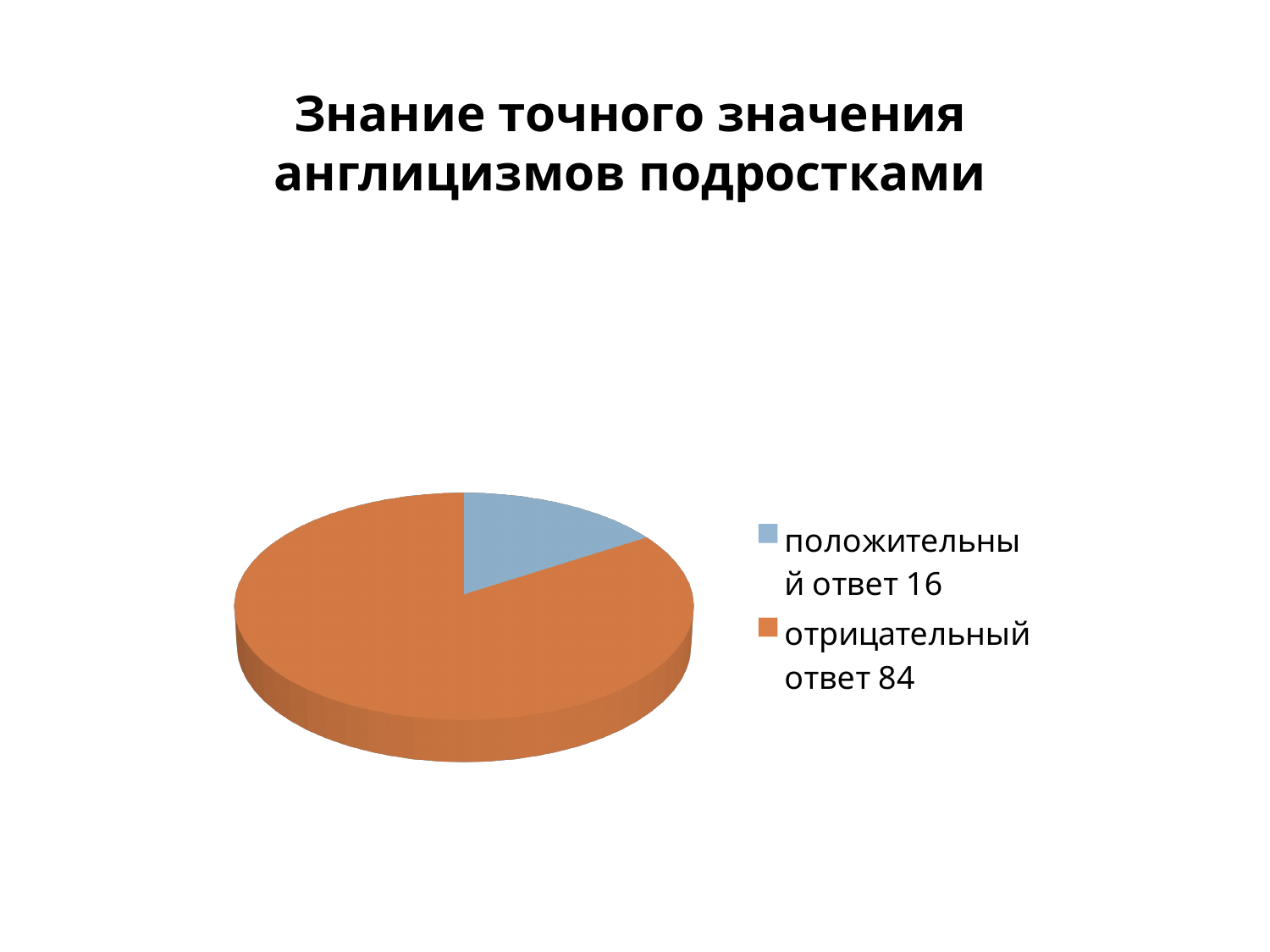
How many entries does the legend list? 2 What number is given for the negative answer (отрицательный ответ) in the legend? 84 Which is larger, the positive answer or the negative answer? отрицательный ответ What is the difference between the negative answer value and the positive answer value? 68 What is the title of the chart? Знание точного значения англицизмов подростками What number is given for the positive answer (положительный ответ) in the legend? 16 How many slices does the pie chart have? 2 Which slice is the largest in the pie chart? отрицательный ответ 84 What kind of chart is shown on the slide? pie chart What colour is the slice for the positive answer (положительный ответ)? blue What share of the pie does the negative answer (отрицательный ответ) take? 84% Which slice is the smallest in the pie chart? положительный ответ 16